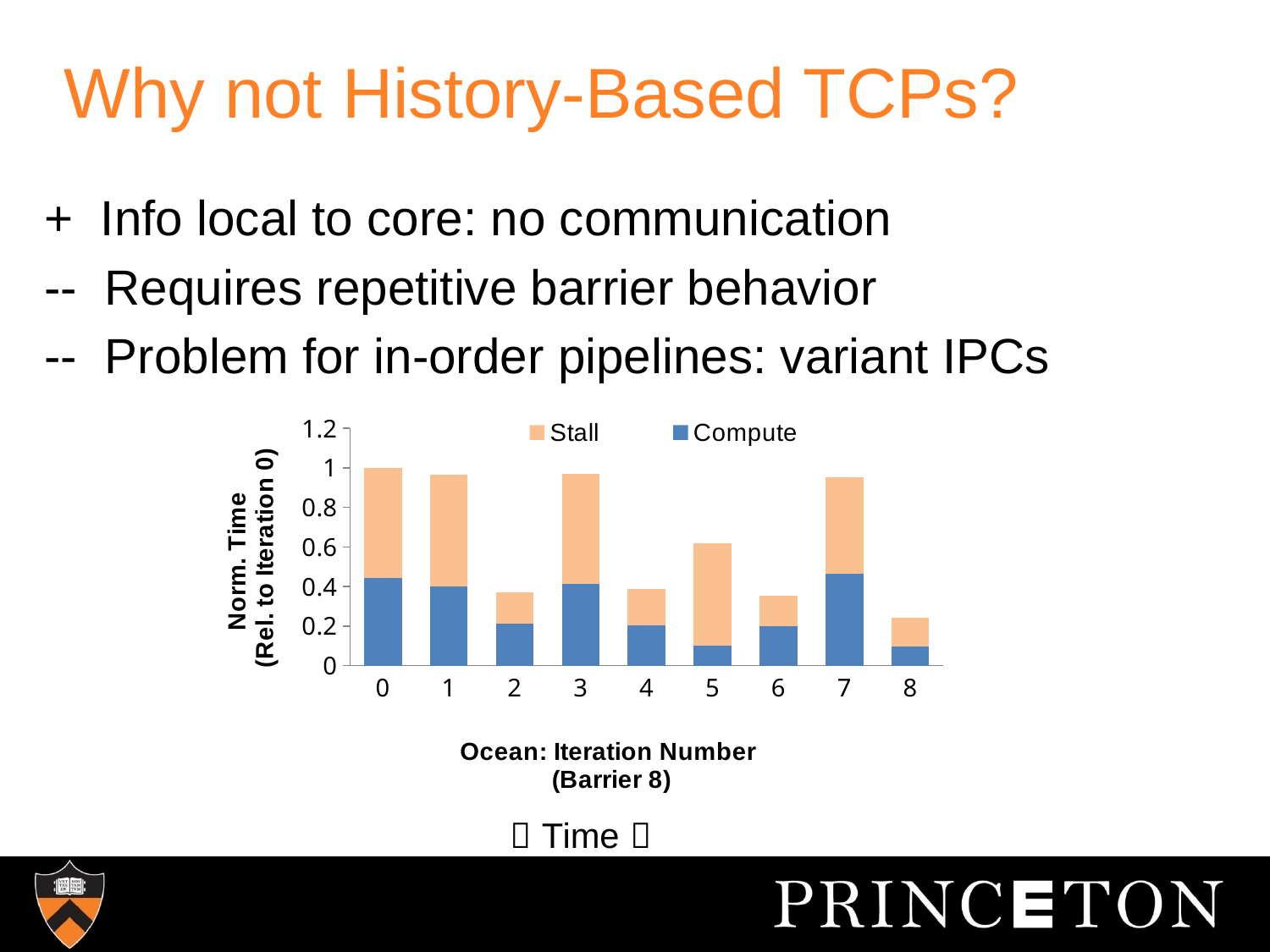
Is the Compute value for iteration 4 greater or less than 0.4? less What is the x-axis title of the chart? Ocean: Iteration Number (Barrier 8) What are the two series named in the chart's legend? Stall and Compute What kind of chart is shown on the slide? Stacked bar chart Which iteration has the lowest total normalized time? 8 Is the total normalized time for iteration 8 greater or less than 0.4? less Is the Compute value for iteration 7 greater or less than 0.4? greater How many series does the chart's legend list? 2 Which has the larger Compute value, iteration 3 or iteration 4? Iteration 3 Which has the larger total normalized time, iteration 5 or iteration 6? Iteration 5 How many iterations (bars) are plotted along the x axis? 9